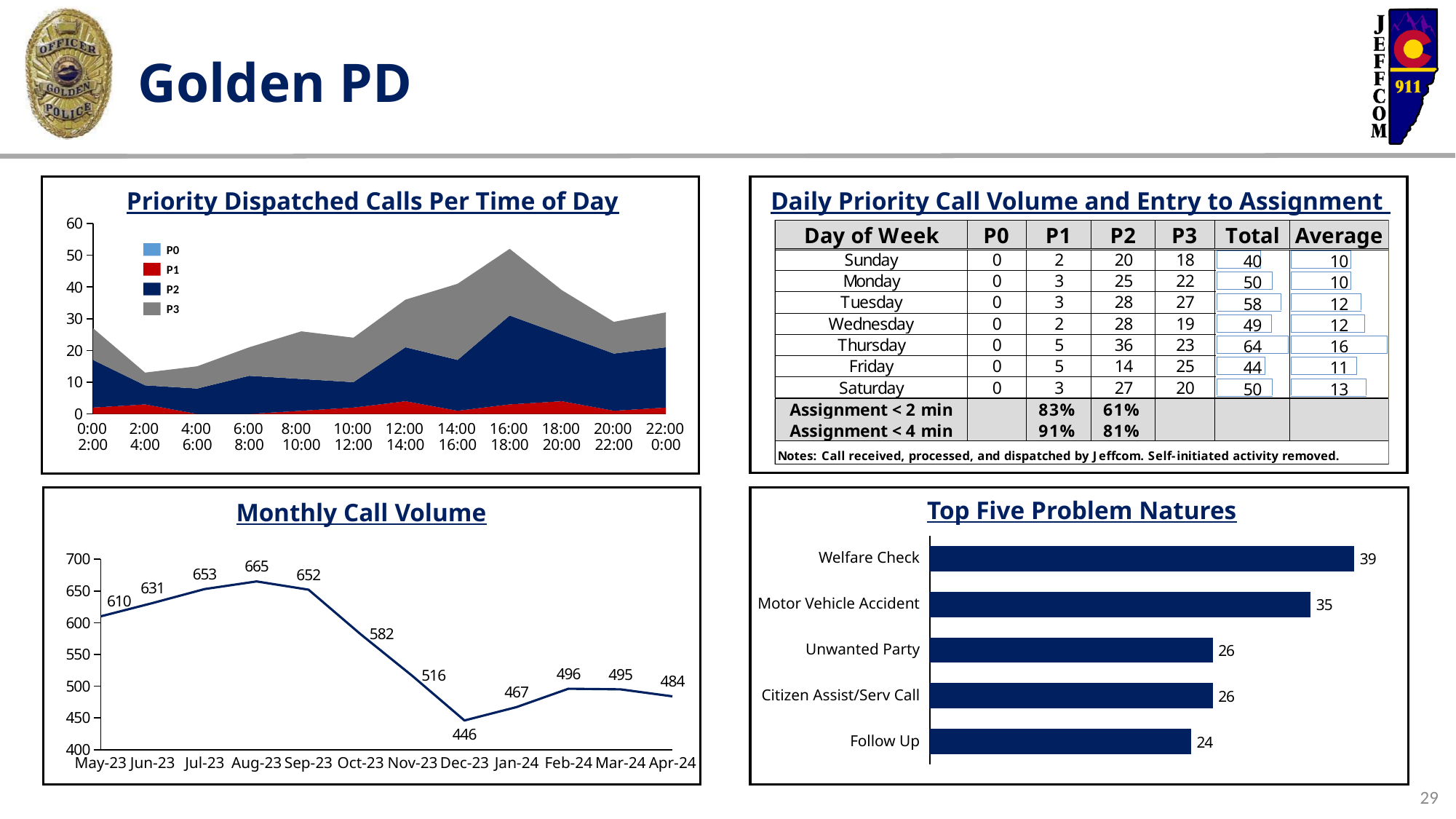
In the Monthly Call Volume chart, which month has the highest call volume? Aug-23 In the Top Five Problem Natures chart, which problem nature has the highest value? Welfare Check In the Monthly Call Volume chart, what is the value for Aug-23? 665 In the Top Five Problem Natures chart, what is the value for Motor Vehicle Accident? 35 In the Monthly Call Volume chart, do the values rise or fall from Sep-23 to Dec-23? fall In the Top Five Problem Natures chart, what is the difference between Welfare Check and Follow Up? 15 What kind of chart is the Top Five Problem Natures chart? bar chart In the Monthly Call Volume chart, which month has the lowest call volume? Dec-23 In the Priority Dispatched Calls Per Time of Day chart, how many series does the legend list? 4 In the Monthly Call Volume chart, how many months are plotted? 12 In the Monthly Call Volume chart, what is the difference between the Aug-23 and Dec-23 values? 219 In the Priority Dispatched Calls Per Time of Day chart, is the total stacked value for the 16:00-18:00 period greater or less than 40? greater